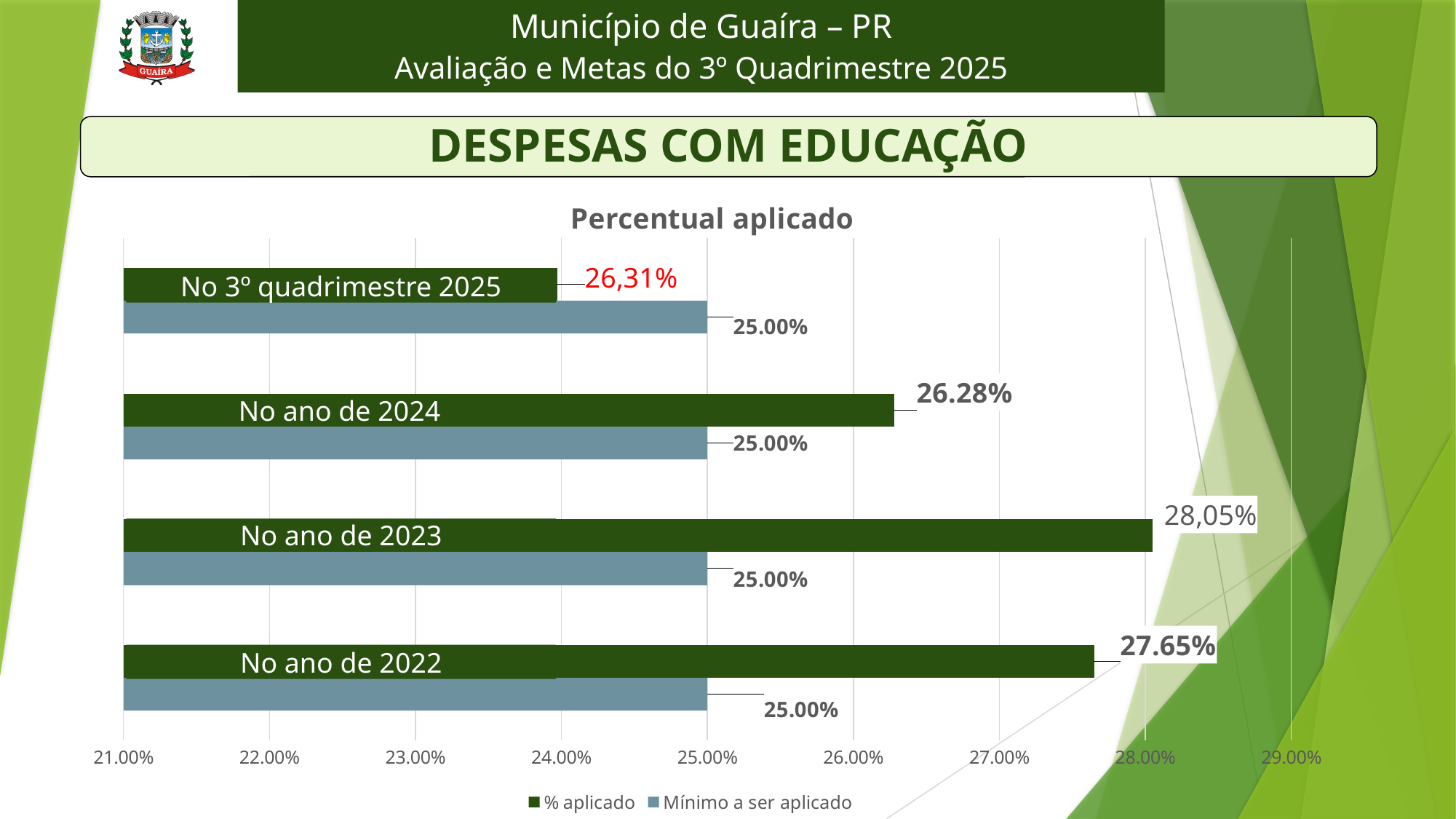
What is the value of "% aplicado" for "No ano de 2024"? 26.28% What is the difference between the "% aplicado" values for "No ano de 2023" and "No ano de 2022"? 0.40% What kind of chart is shown on the slide? bar chart How many categories are shown on the chart? 4 What is the value of "% aplicado" for "No ano de 2023"? 28,05% Which is larger, the "% aplicado" value for "No ano de 2024" or for "No ano de 2022"? No ano de 2022 Is the "% aplicado" value for "No ano de 2022" greater or less than 27.00%? greater What is the difference between the "% aplicado" and "Mínimo a ser aplicado" values for "No ano de 2024"? 1.28% What is the value of "% aplicado" for "No ano de 2022"? 27.65% How many series does the legend list? 2 Which category has the highest "% aplicado" value? No ano de 2023 What is the value of "Mínimo a ser aplicado" for "No ano de 2022"? 25.00%